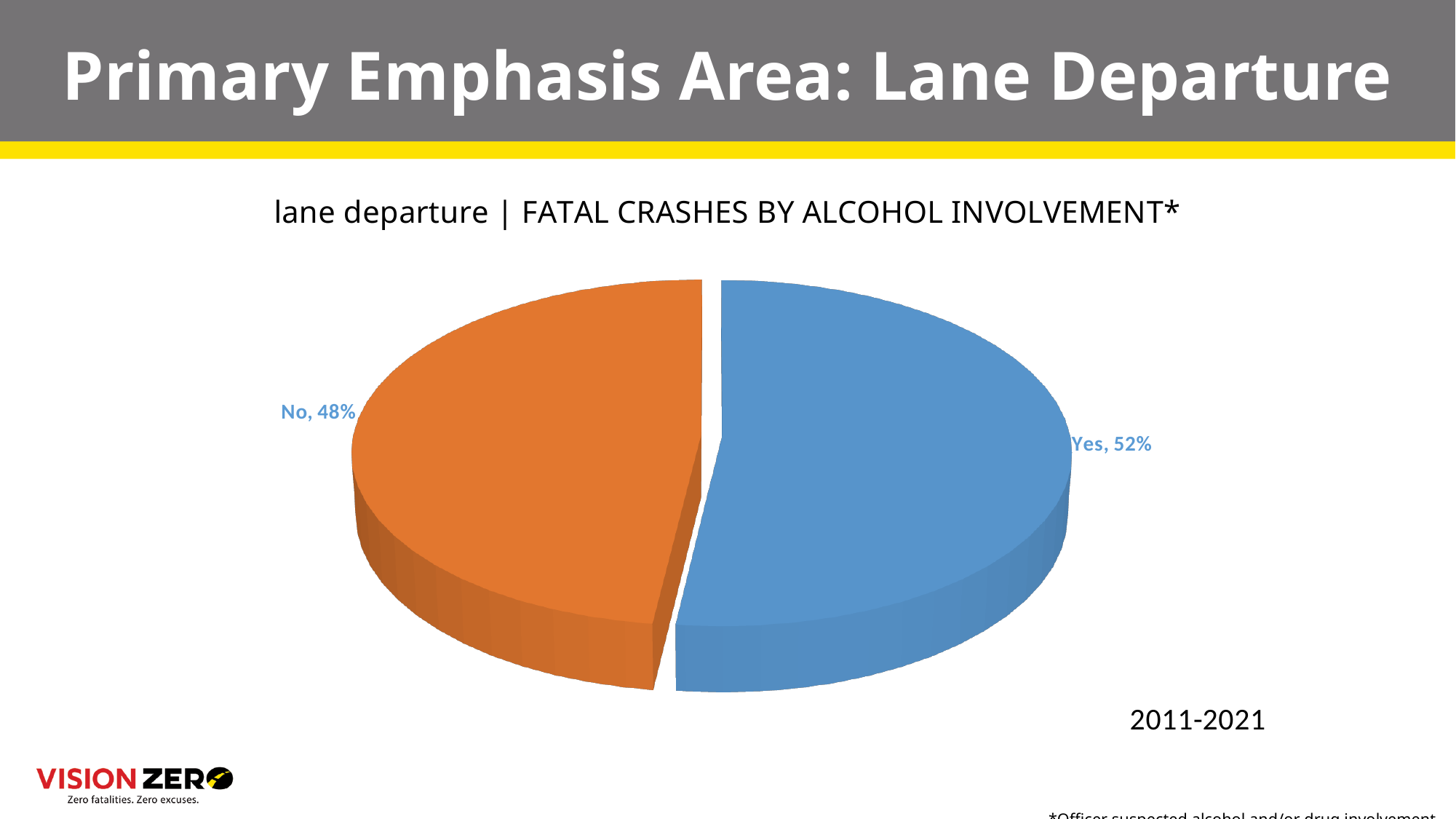
What share of lane departure fatal crashes involved alcohol (Yes)? 52% What kind of chart is shown on the slide? Pie chart What share of lane departure fatal crashes did not involve alcohol (No)? 48% Which slice of the pie is larger, Yes or No? Yes What is the difference in percentage points between the Yes and No slices? 4 What time period does the chart cover? 2011-2021 What colour is the Yes slice of the pie? Blue How many slices does the pie chart have? 2 What is the title of the chart? lane departure | FATAL CRASHES BY ALCOHOL INVOLVEMENT* Which category has the largest share of the pie? Yes Is the share for No greater or less than 50%? less Which category has the smallest share of the pie? No